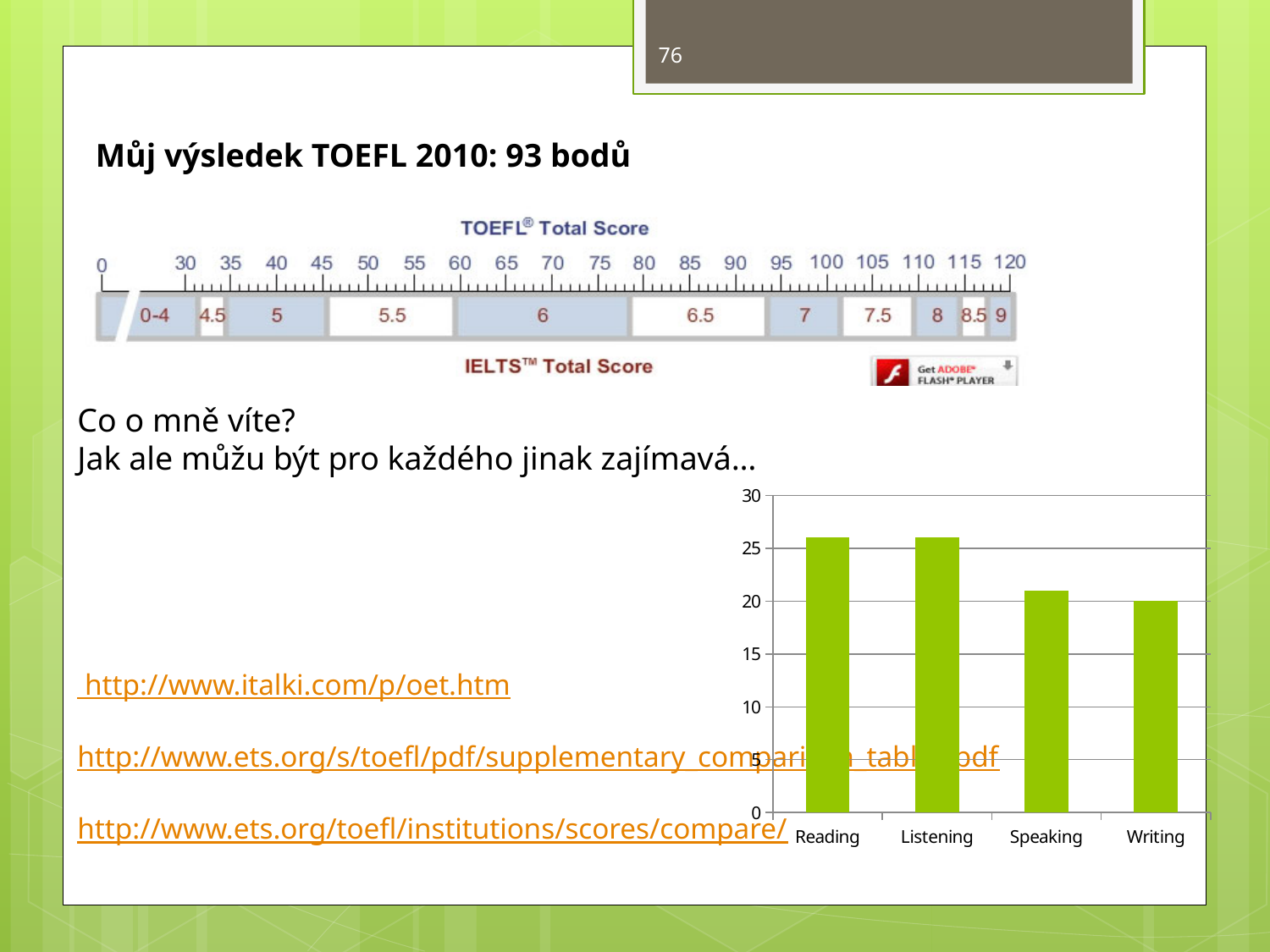
Is the value for Reading in the bar chart greater or less than 25? greater What is the highest value shown on the vertical axis of the bar chart? 30 How many categories does the bar chart show? 4 In the bar chart, which is larger, Listening or Writing? Listening Is the value for Listening in the bar chart greater or less than 20? greater In the bar chart, which is larger, Reading or Speaking? Reading What is the value for Writing in the bar chart? 20 What kind of chart is shown at the bottom right of the slide? bar chart Is the value for Writing in the bar chart greater or less than 25? less What colour are the bars in the bar chart? green